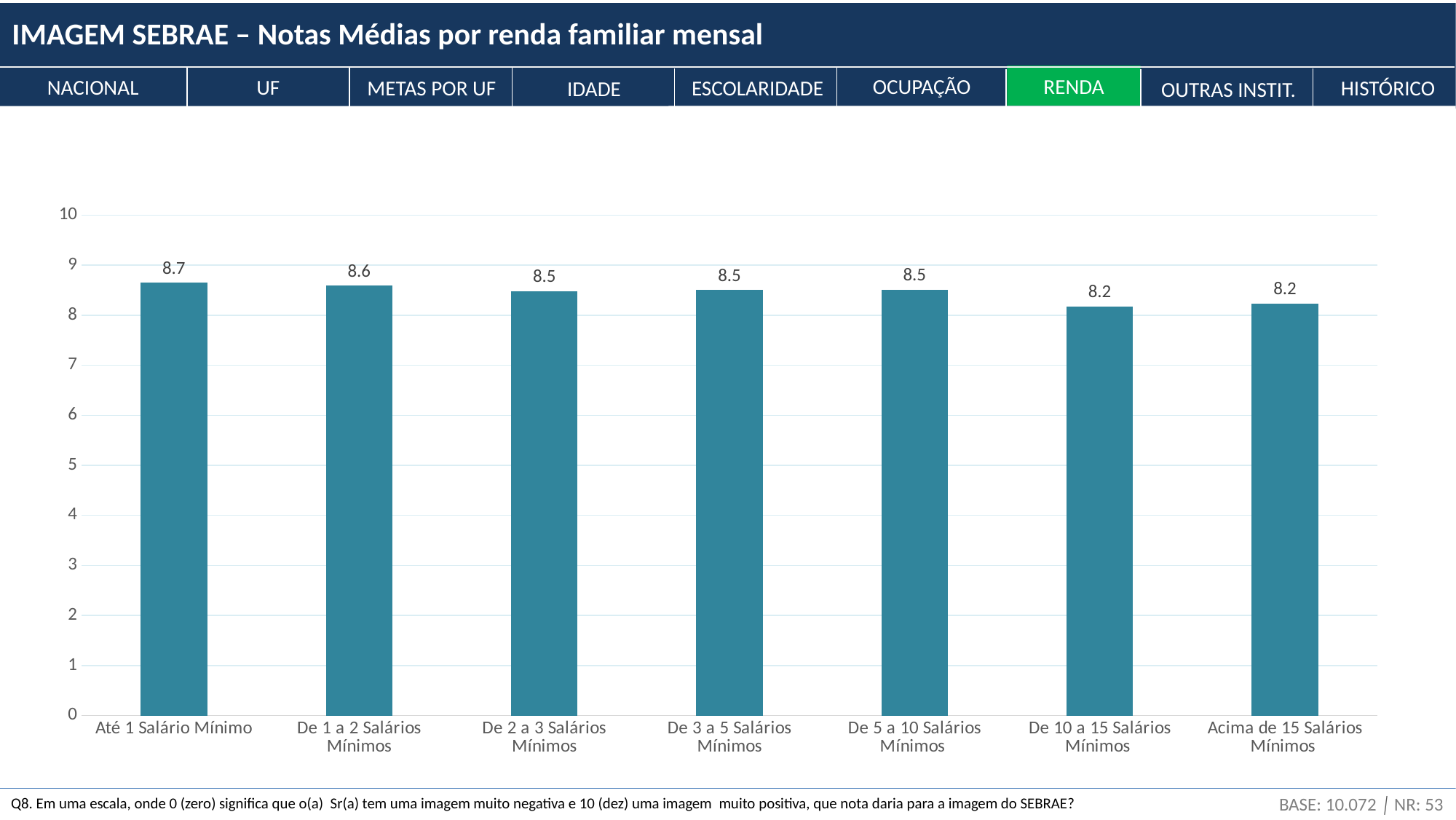
Do the values generally rise or fall from left to right along the x axis? fall What is the value for 'Até 1 Salário Mínimo'? 8.7 What kind of chart is shown on the slide? bar chart Which category has the highest value? Até 1 Salário Mínimo What is the title of the slide? IMAGEM SEBRAE – Notas Médias por renda familiar mensal Which is larger, the value for 'De 1 a 2 Salários Mínimos' or the value for 'De 10 a 15 Salários Mínimos'? De 1 a 2 Salários Mínimos What is the value for 'De 5 a 10 Salários Mínimos'? 8.5 What is the difference between the values for 'Até 1 Salário Mínimo' and 'Acima de 15 Salários Mínimos'? 0.5 What is the value for 'De 1 a 2 Salários Mínimos'? 8.6 How many categories are shown on the x axis? 7 What is the value for 'De 10 a 15 Salários Mínimos'? 8.2 Is the value for 'De 3 a 5 Salários Mínimos' greater or less than 8? greater